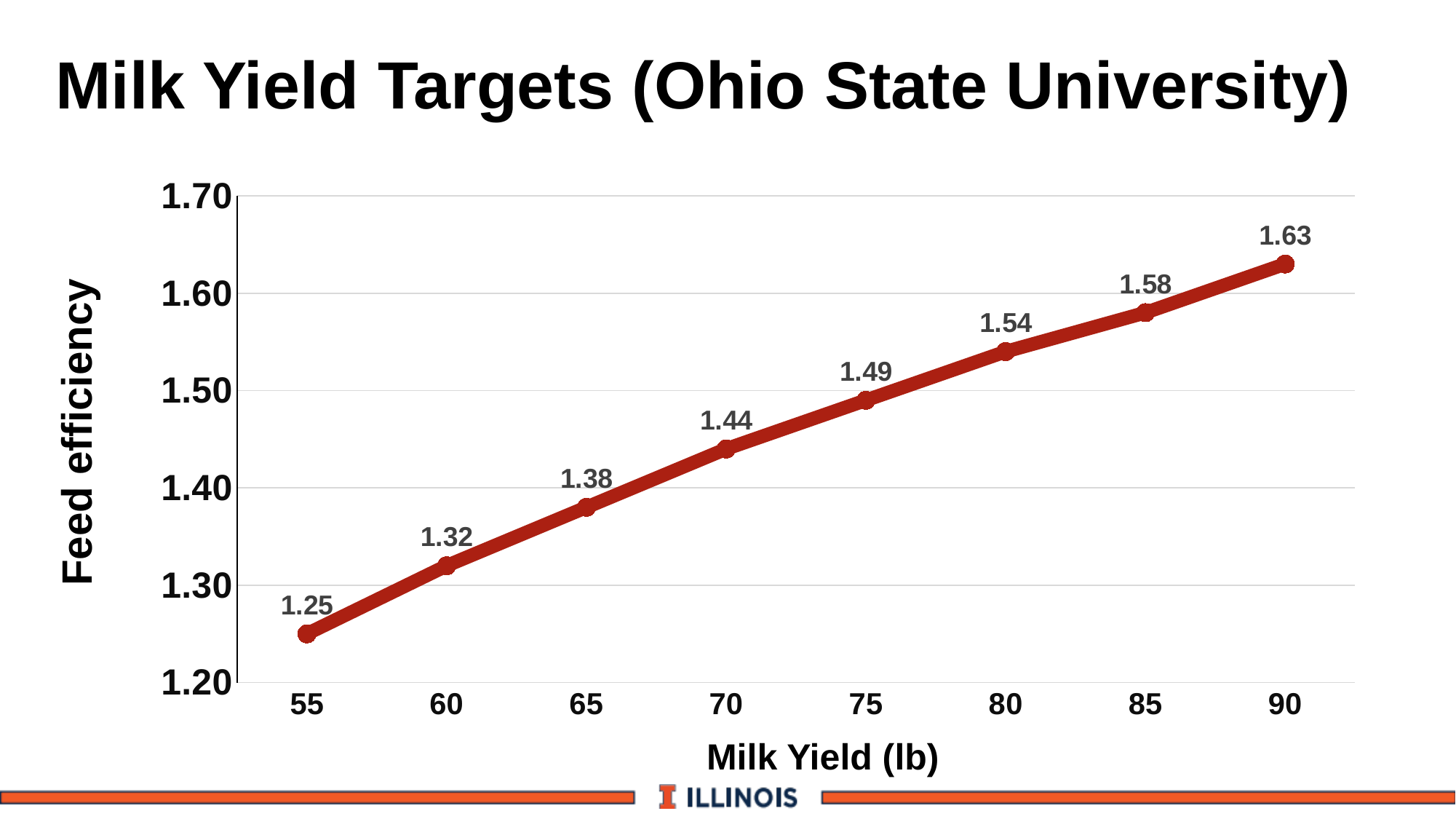
What is the feed efficiency at a milk yield of 85 lb? 1.58 Which has a higher feed efficiency, a milk yield of 60 lb or 80 lb? 80 Does feed efficiency rise or fall as milk yield increases? rise At which milk yield is feed efficiency highest? 90 What is the feed efficiency at a milk yield of 55 lb? 1.25 What is the difference in feed efficiency between a milk yield of 75 lb and 65 lb? 0.11 At which milk yield is feed efficiency lowest? 55 What kind of chart is shown on the slide? line chart What is the feed efficiency at a milk yield of 70 lb? 1.44 How many data points are plotted on the chart? 8 What is the difference in feed efficiency between a milk yield of 90 lb and 55 lb? 0.38 Is the feed efficiency at a milk yield of 75 lb greater or less than 1.50? less